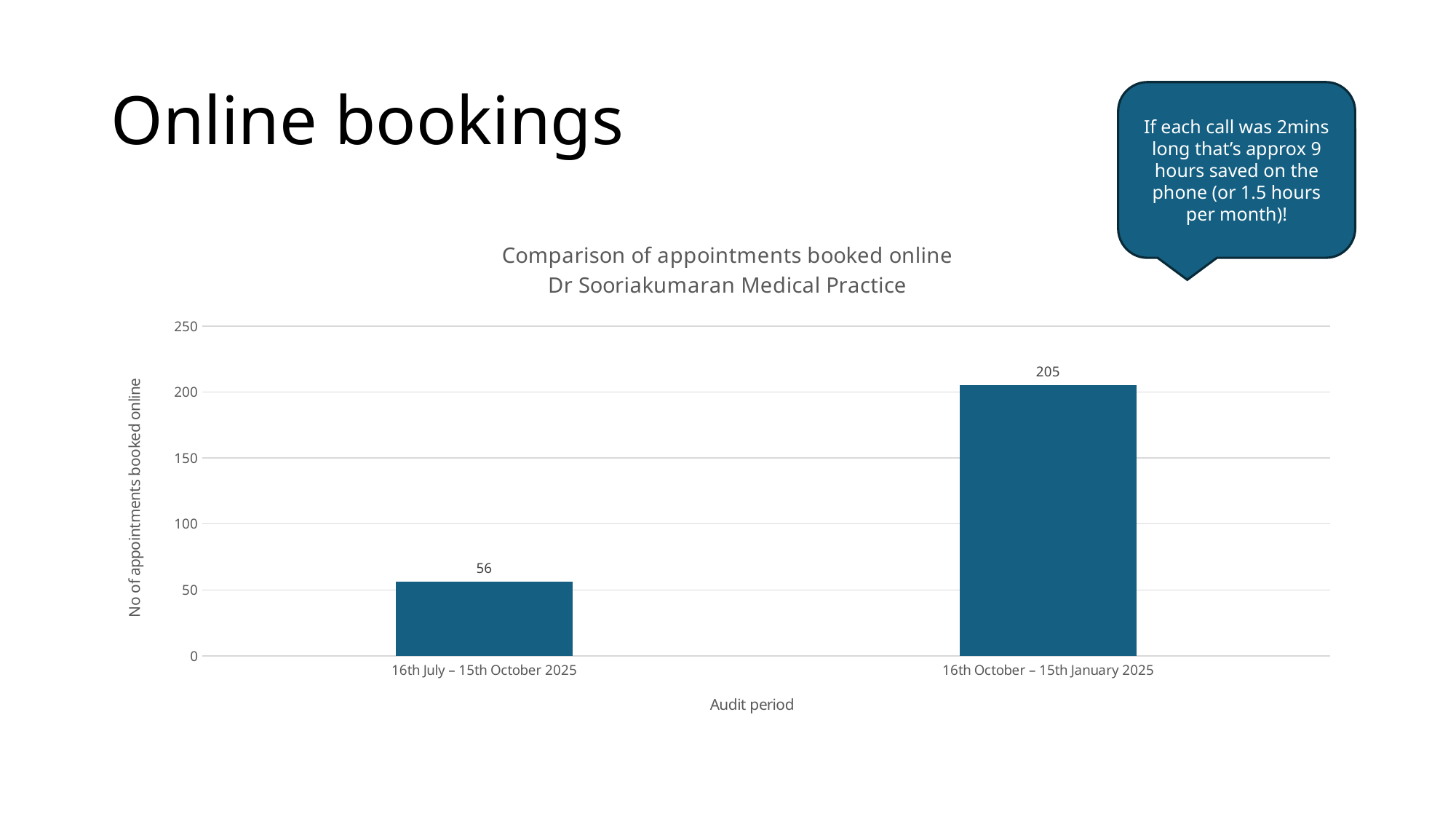
What is the difference in appointments booked online between the 16th October – 15th January 2025 period and the 16th July – 15th October 2025 period? 149 How many appointments were booked online in the audit period 16th July – 15th October 2025? 56 Is the value for 16th October – 15th January 2025 greater or less than 200? greater Is the value for 16th July – 15th October 2025 greater or less than 100? less How many appointments were booked online in the audit period 16th October – 15th January 2025? 205 Which audit period has the lowest number of appointments booked online? 16th July – 15th October 2025 What kind of chart is shown on the slide? Bar chart Do the values rise or fall from the first audit period to the second? Rise Which audit period has the highest number of appointments booked online? 16th October – 15th January 2025 How many audit periods are shown on the chart? 2 Which audit period has more appointments booked online: 16th July – 15th October 2025 or 16th October – 15th January 2025? 16th October – 15th January 2025 What is the label of the vertical axis of the chart? No of appointments booked online